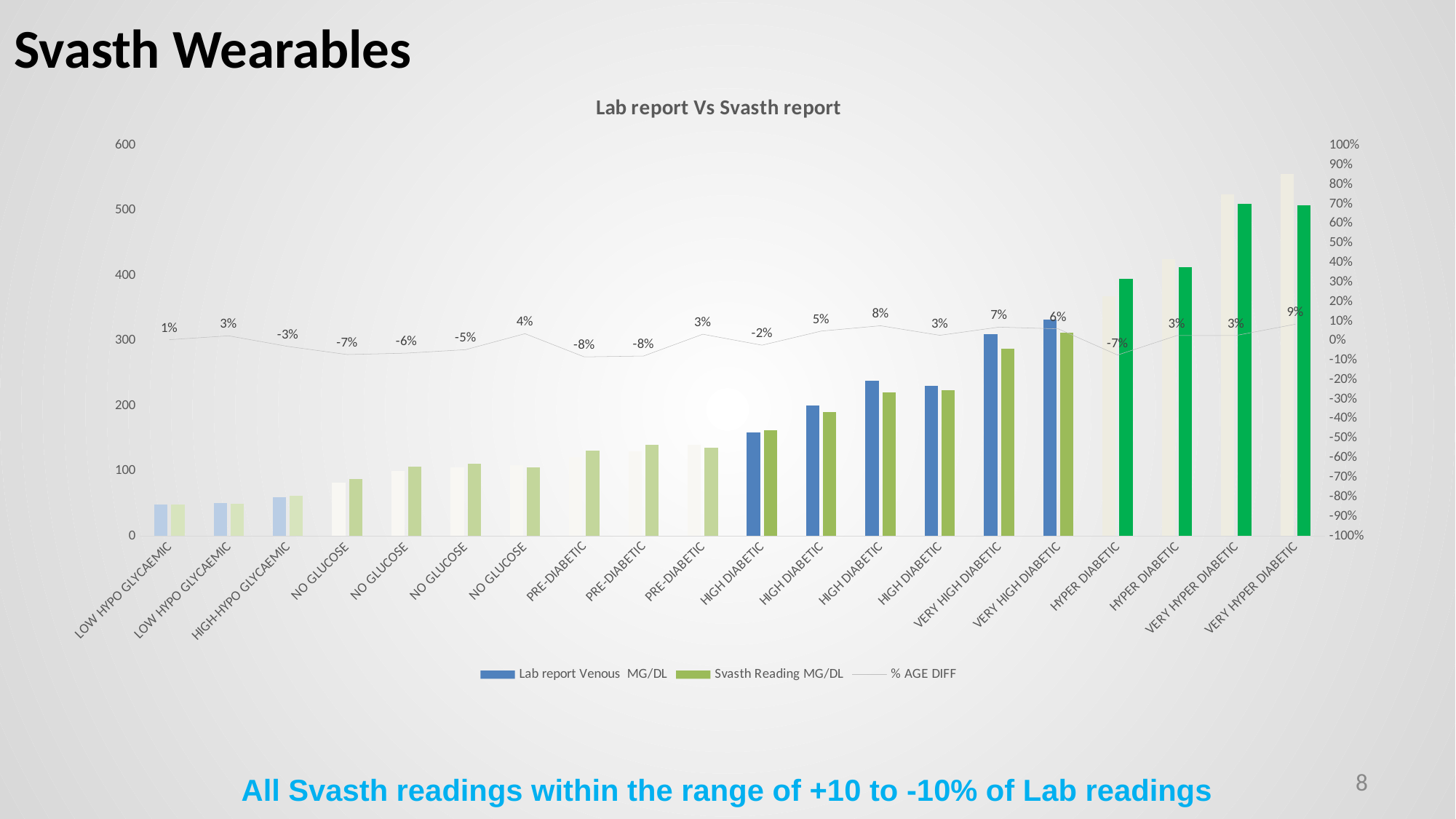
Is the Lab report Venous MG/DL value for the last VERY HYPER DIABETIC category greater or less than 500? greater What is the % AGE DIFF value for the first LOW HYPO GLYCAEMIC category (leftmost)? 1% How many series does the chart legend list? 3 What is the lowest % AGE DIFF value shown on the chart? -8% What is the title of the chart? Lab report Vs Svasth report Do the Lab report Venous MG/DL values generally rise or fall from left to right along the x axis? rise What is the % AGE DIFF value for the HIGH-HYPO GLYCAEMIC category? -3% What is the % AGE DIFF value for the last category on the right (second VERY HYPER DIABETIC)? 9% What is the highest % AGE DIFF value shown on the chart? 9% Is the Svasth Reading MG/DL value for the HIGH-HYPO GLYCAEMIC category greater or less than 100? less What kind of chart is shown on the slide? Bar chart with a line series How many categories are plotted along the x axis of the chart? 20